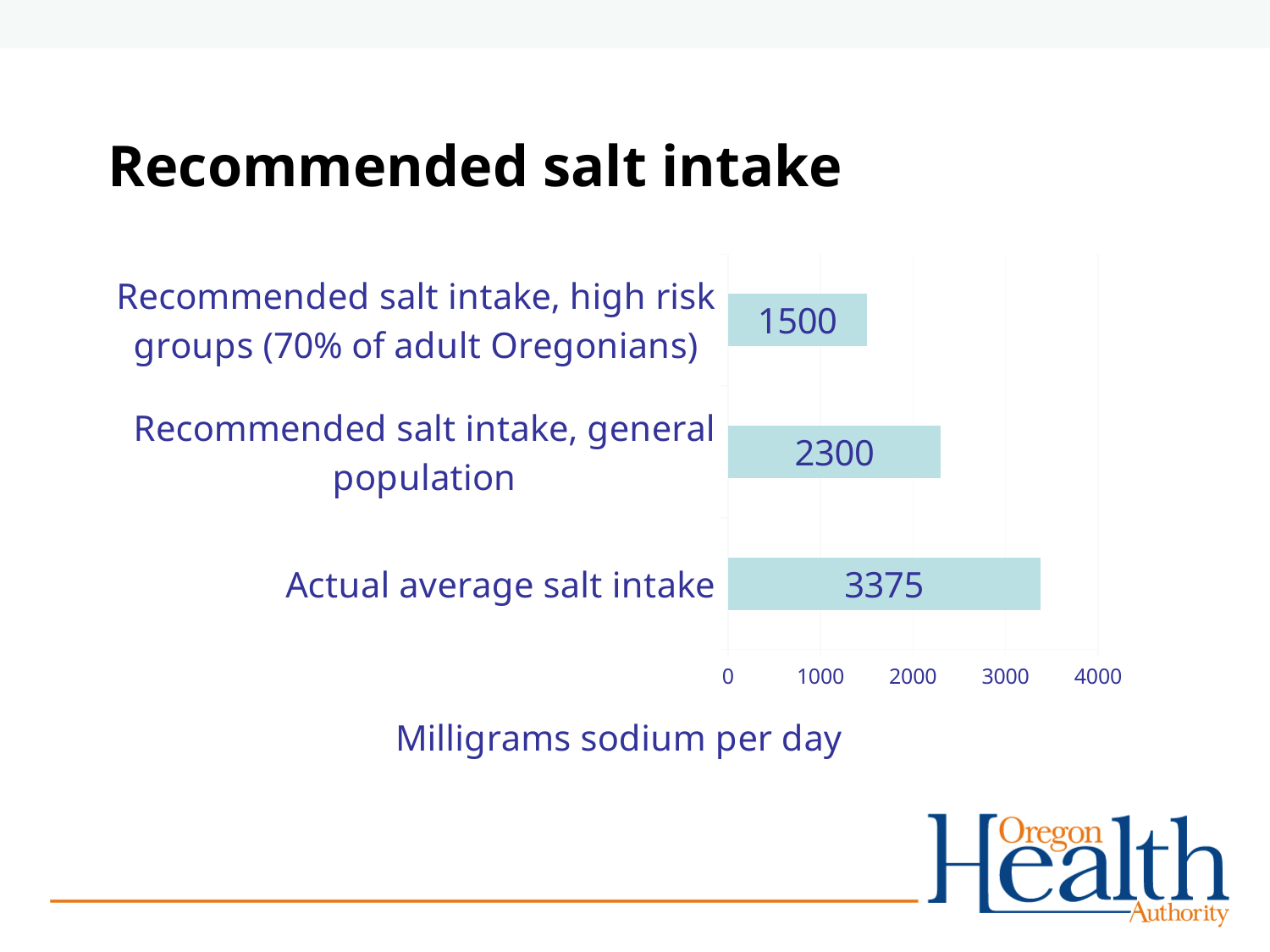
What is the value for Recommended salt intake, general population? 2300 What is the label of the horizontal axis? Milligrams sodium per day How many categories are shown in the chart? 3 What is the difference between Recommended salt intake, general population and Recommended salt intake, high risk groups? 800 Which is larger: Actual average salt intake or Recommended salt intake, general population? Actual average salt intake Is the value for Actual average salt intake greater or less than 3000? greater What kind of chart is shown on the slide? Bar chart What is the difference between Actual average salt intake and Recommended salt intake, general population? 1075 What is the value for Actual average salt intake? 3375 Which category has the highest value? Actual average salt intake Which category has the lowest value? Recommended salt intake, high risk groups (70% of adult Oregonians) What is the value for Recommended salt intake, high risk groups (70% of adult Oregonians)? 1500